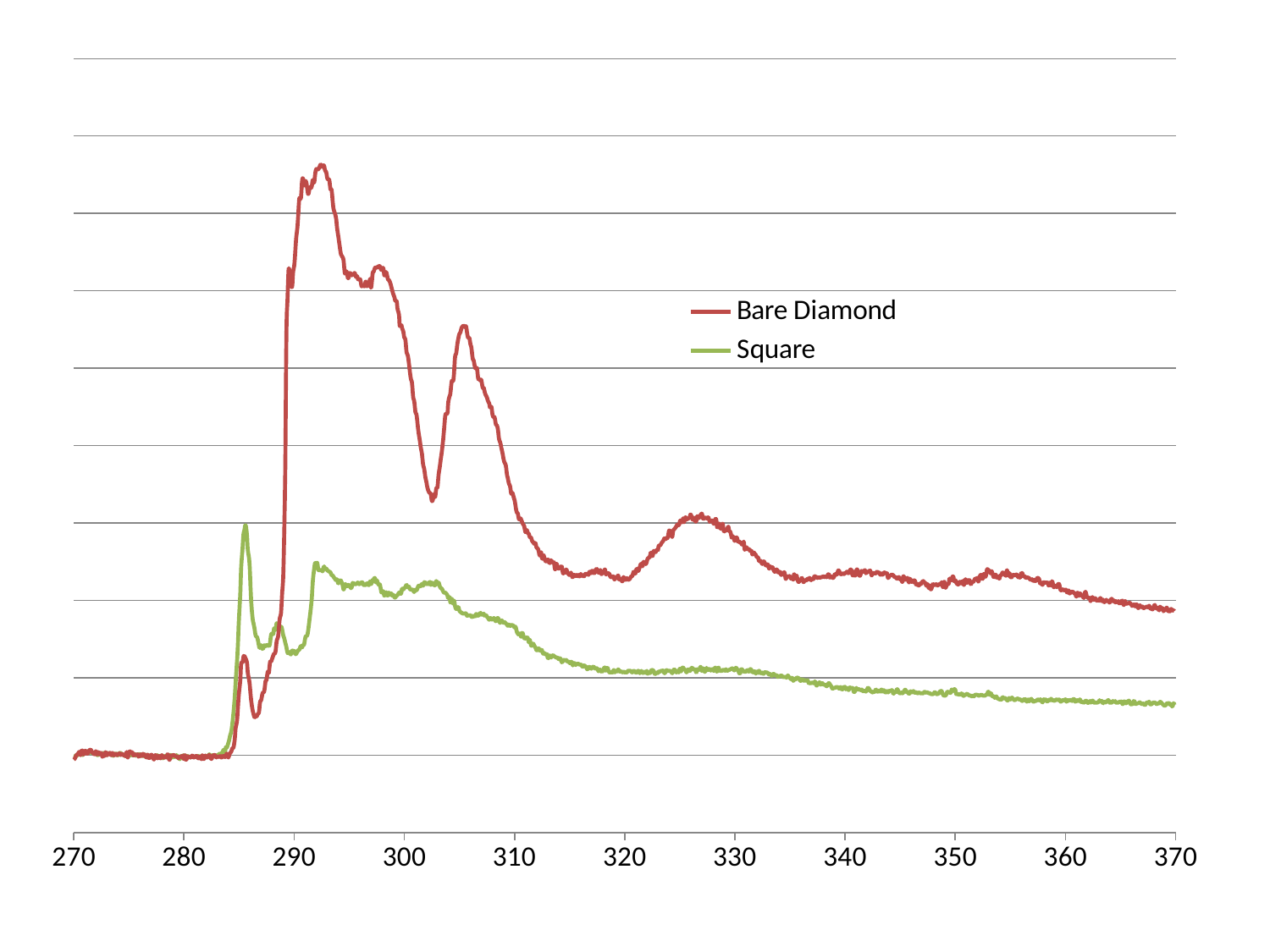
What is the highest value labelled on the x axis? 370 What colour is the Square series line? green Which series reaches the higher peak value overall? Bare Diamond Does the Bare Diamond series rise or fall between x = 330 and x = 370? fall At x = 370, which series has the higher value? Bare Diamond At x = 350, which series has the lower value, Bare Diamond or Square? Square What kind of chart is shown on the slide? line chart What are the two series named in the legend? Bare Diamond and Square How many series does the legend list? 2 Does the Square series rise or fall between x = 310 and x = 370? fall What is the lowest value labelled on the x axis? 270 At x = 300, which series has the higher value, Bare Diamond or Square? Bare Diamond